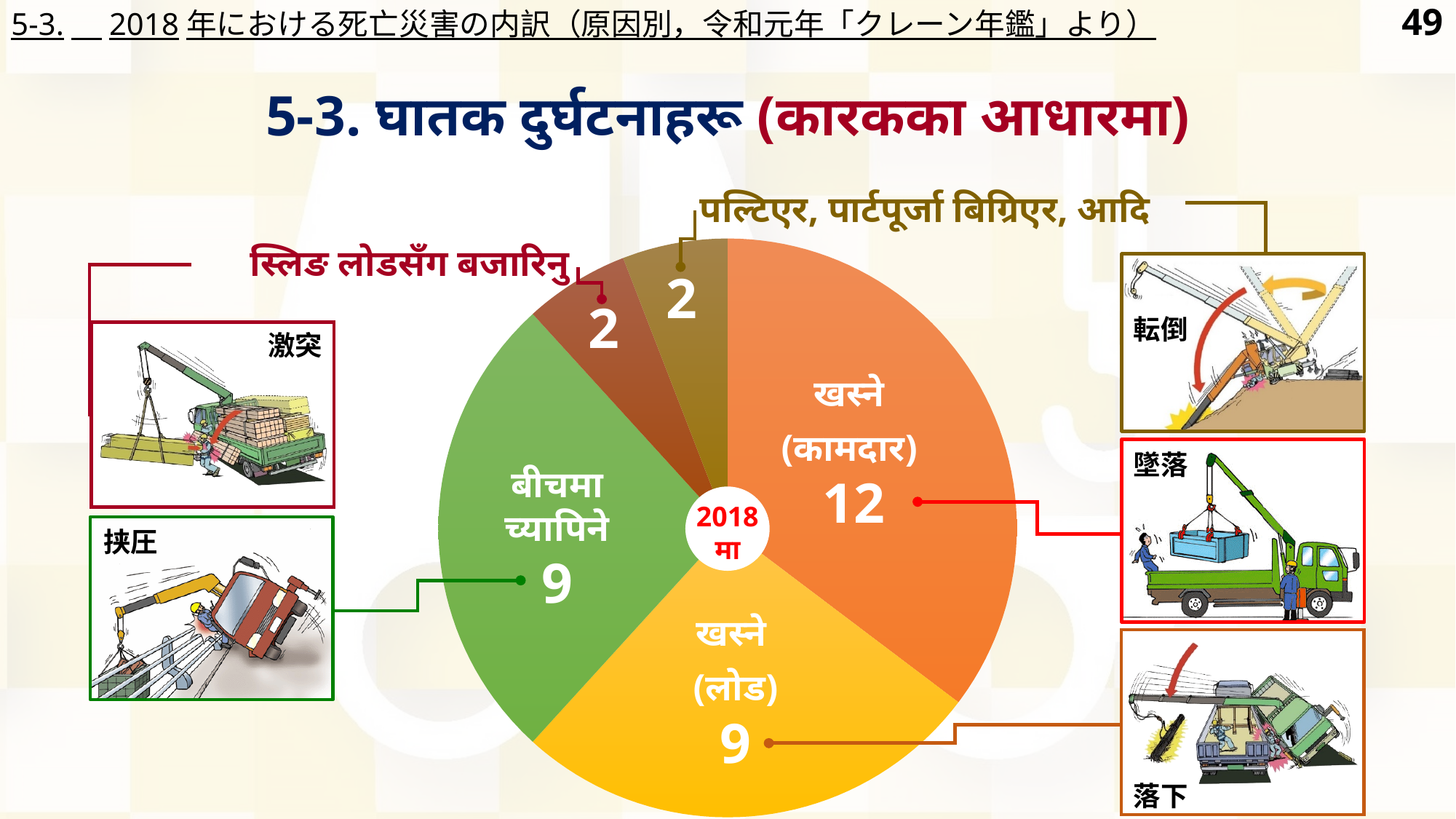
What is the value for खस्ने (कामदार) in the pie chart? 12 What is the value for बीचमा च्यापिने in the pie chart? 9 What is the difference between the values for खस्ने (कामदार) and खस्ने (लोड)? 3 Which is larger, the value for बीचमा च्यापिने or the value for स्लिङ लोडसँग बजारिनु? बीचमा च्यापिने What year is written in the centre of the pie chart? 2018 What is the value for स्लिङ लोडसँग बजारिनु in the pie chart? 2 Which category has the largest slice in the pie chart? खस्ने (कामदार) What kind of chart is shown on the slide? pie chart What is the total of all the values shown in the pie chart? 34 How many slices does the pie chart have? 5 What is the value for खस्ने (लोड) in the pie chart? 9 What is the value for पल्टिएर, पार्टपूर्जा बिग्रिएर, आदि in the pie chart? 2